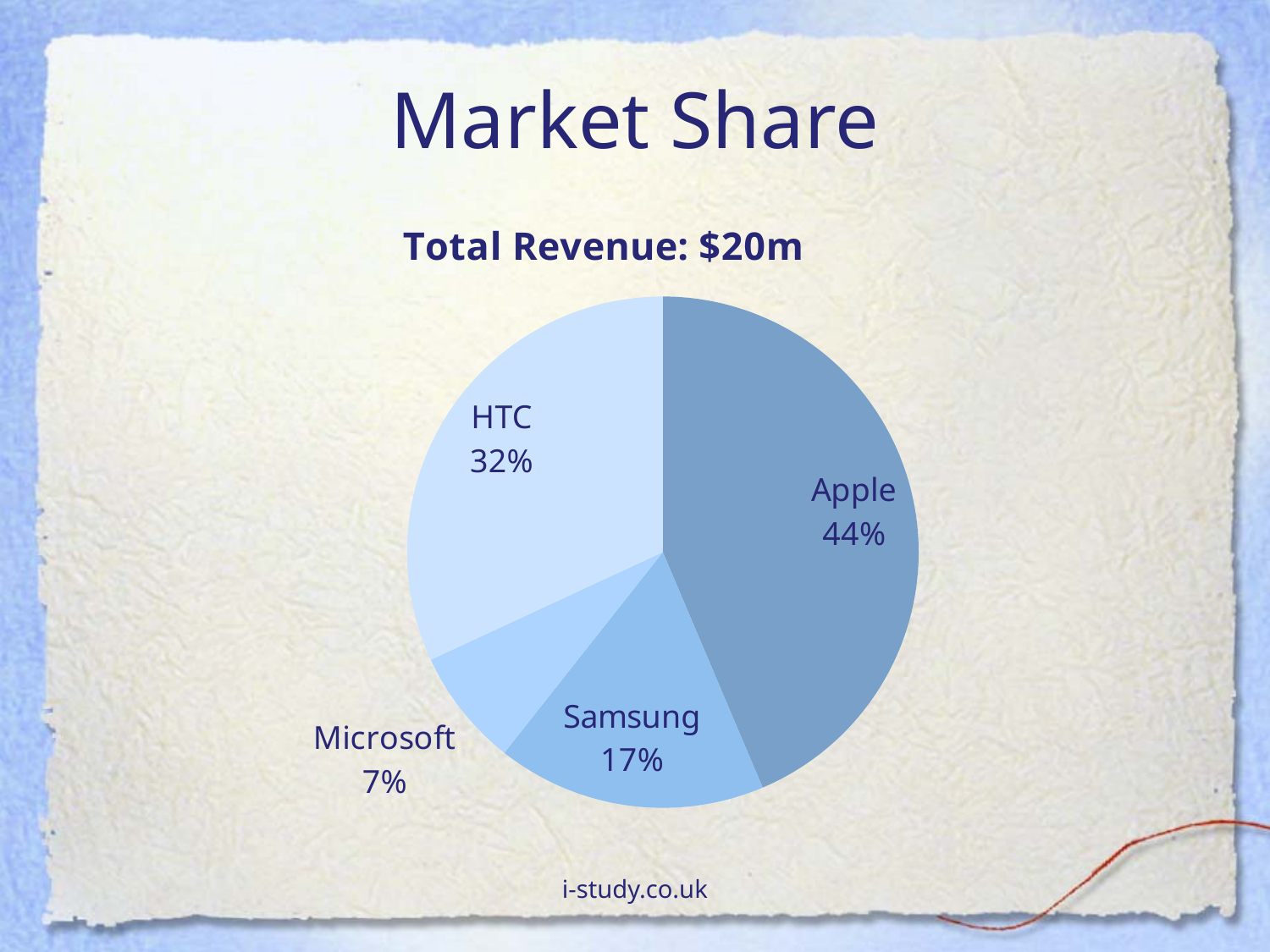
How many companies are shown in the pie chart? 4 What total revenue is stated above the chart? $20m What is the difference in market share between Apple and HTC? 12% Which company has the smallest market share? Microsoft What is Apple's market share? 44% What is Microsoft's market share? 7% What is Samsung's market share? 17% What is the title of the slide? Market Share What is HTC's market share? 32% What kind of chart is shown on the slide? pie chart Which has a larger market share, Samsung or Microsoft? Samsung Which company has the largest market share? Apple